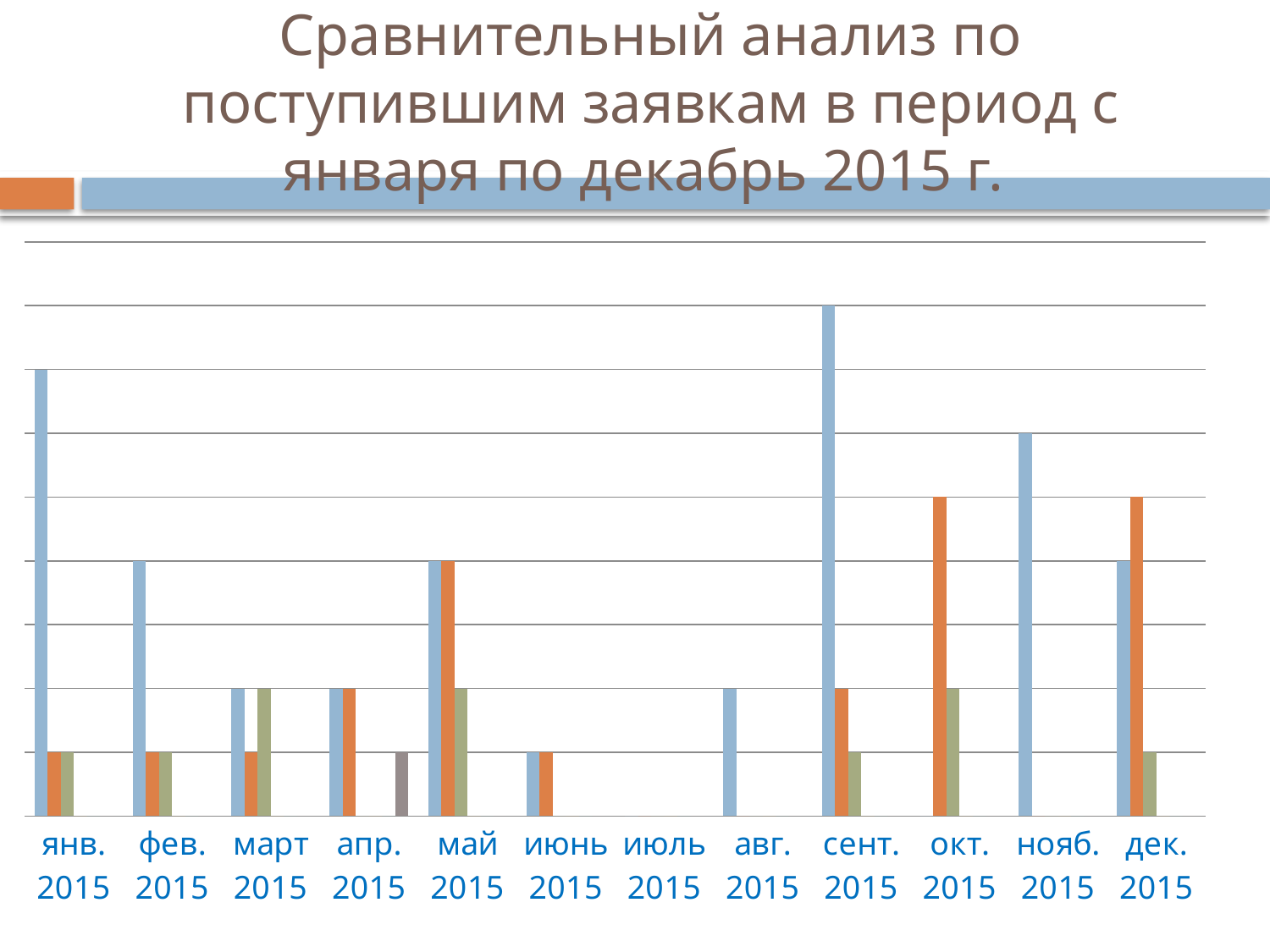
Which has the taller blue bar, май 2015 or июнь 2015? май 2015 What is the title of the slide containing the chart? Сравнительный анализ по поступившим заявкам в период с января по декабрь 2015 г. Which month has the tallest blue bar in the chart? сент. 2015 Which has the taller orange bar, сент. 2015 or окт. 2015? окт. 2015 Which month has no bars at all in the chart? июль 2015 Is the blue bar for янв. 2015 taller or shorter than the blue bar for фев. 2015? taller Which month is the only one with a grey bar in the chart? апр. 2015 How many months (categories) are shown on the x axis of the chart? 12 What kind of chart is shown on the slide? bar chart